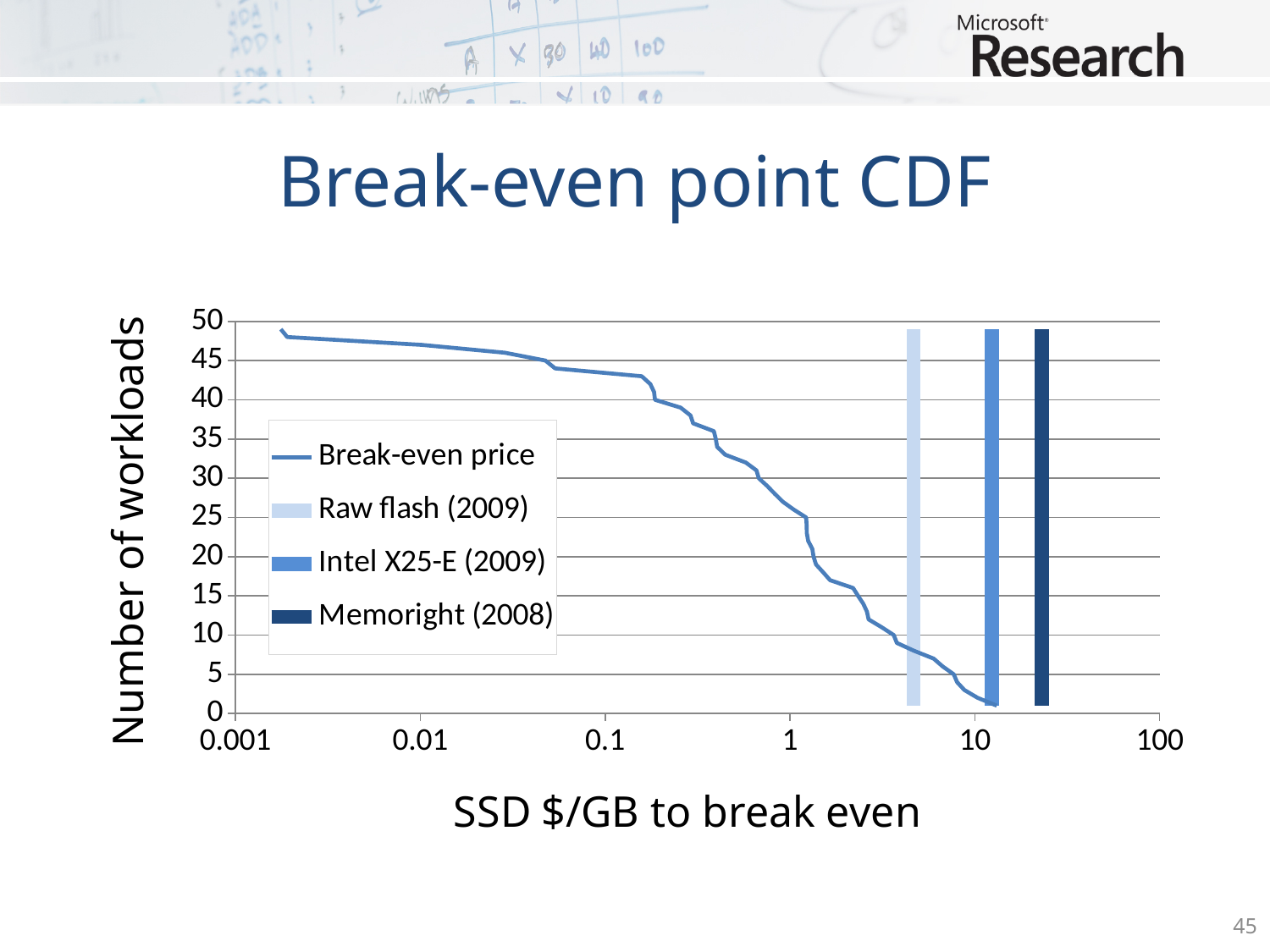
What is the title of the chart? Break-even point CDF Is the SSD $/GB value of the Memoright (2008) bar greater or less than 10? greater At an SSD price of 10 $/GB, is the number of workloads on the Break-even price line greater or less than 5? less Which of the three SSD price bars is positioned furthest to the left on the x axis? Raw flash (2009) How many entries does the legend list? 4 What is the label of the x axis? SSD $/GB to break even Does the Break-even price line rise or fall as the SSD $/GB value increases along the x axis? fall At an SSD price of 0.1 $/GB, is the number of workloads on the Break-even price line greater or less than 40? greater What kind of chart is used to plot the Break-even price series? line chart Which of the three SSD price bars is positioned furthest to the right on the x axis? Memoright (2008)